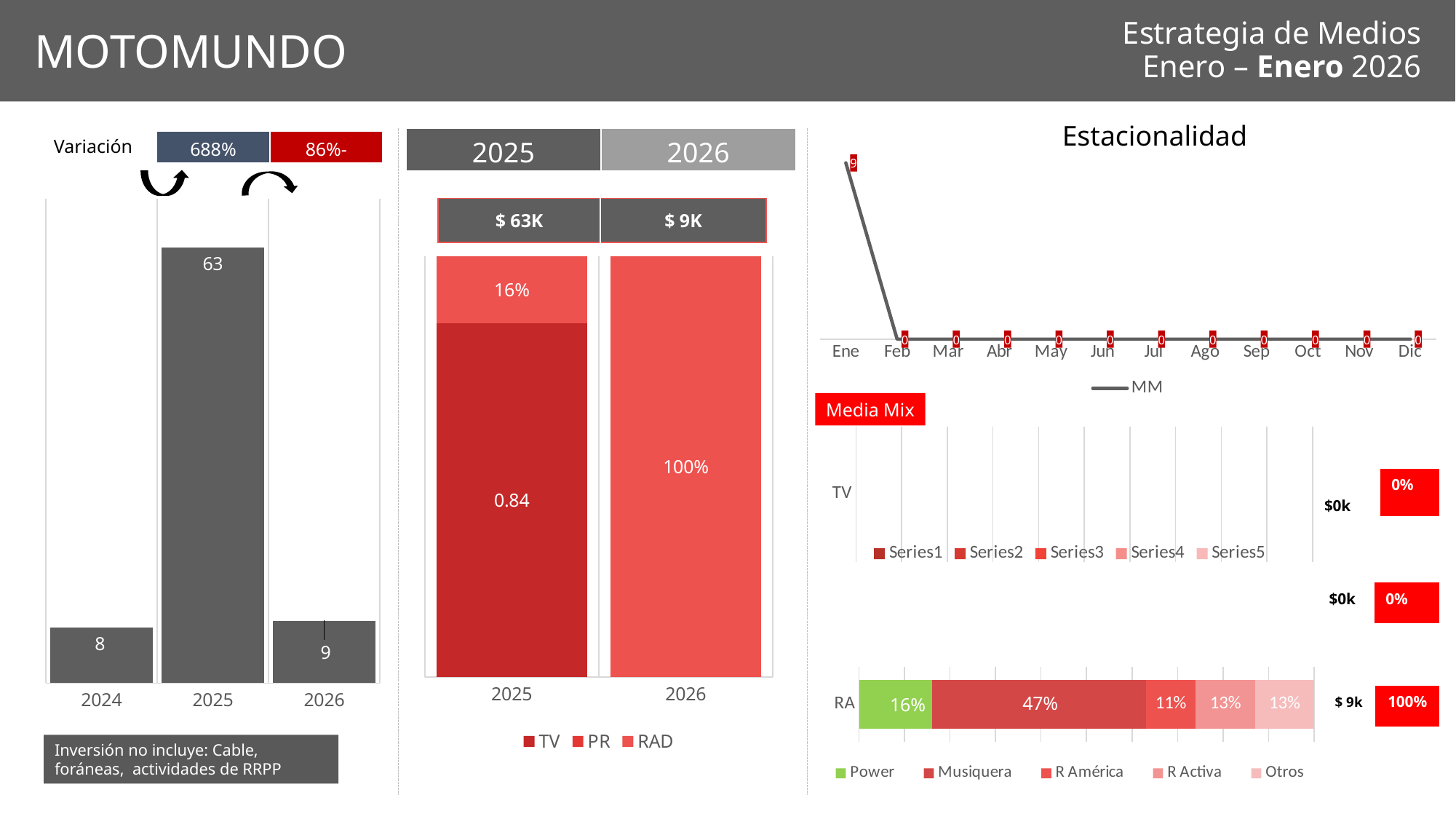
In the left bar chart of yearly investment, which year has the lowest value? 2024 In the left bar chart of yearly investment, which year has the highest value? 2025 In the left bar chart of yearly investment, how many years are shown? 3 In the Media Mix RA bar, what is the share for Musiquera? 47% What kind of chart is the Estacionalidad chart? line chart In the left bar chart of yearly investment, what is the value for 2025? 63 In the middle stacked bar chart comparing 2025 and 2026, what share does RAD have in 2026? 100% In the left bar chart of yearly investment, what is the difference between the 2025 and 2026 values? 54 In the Estacionalidad chart, what is the value for Ene? 9 In the Media Mix RA bar, which station has the largest share? Musiquera In the middle stacked bar chart comparing 2025 and 2026, how many series does the legend list? 3